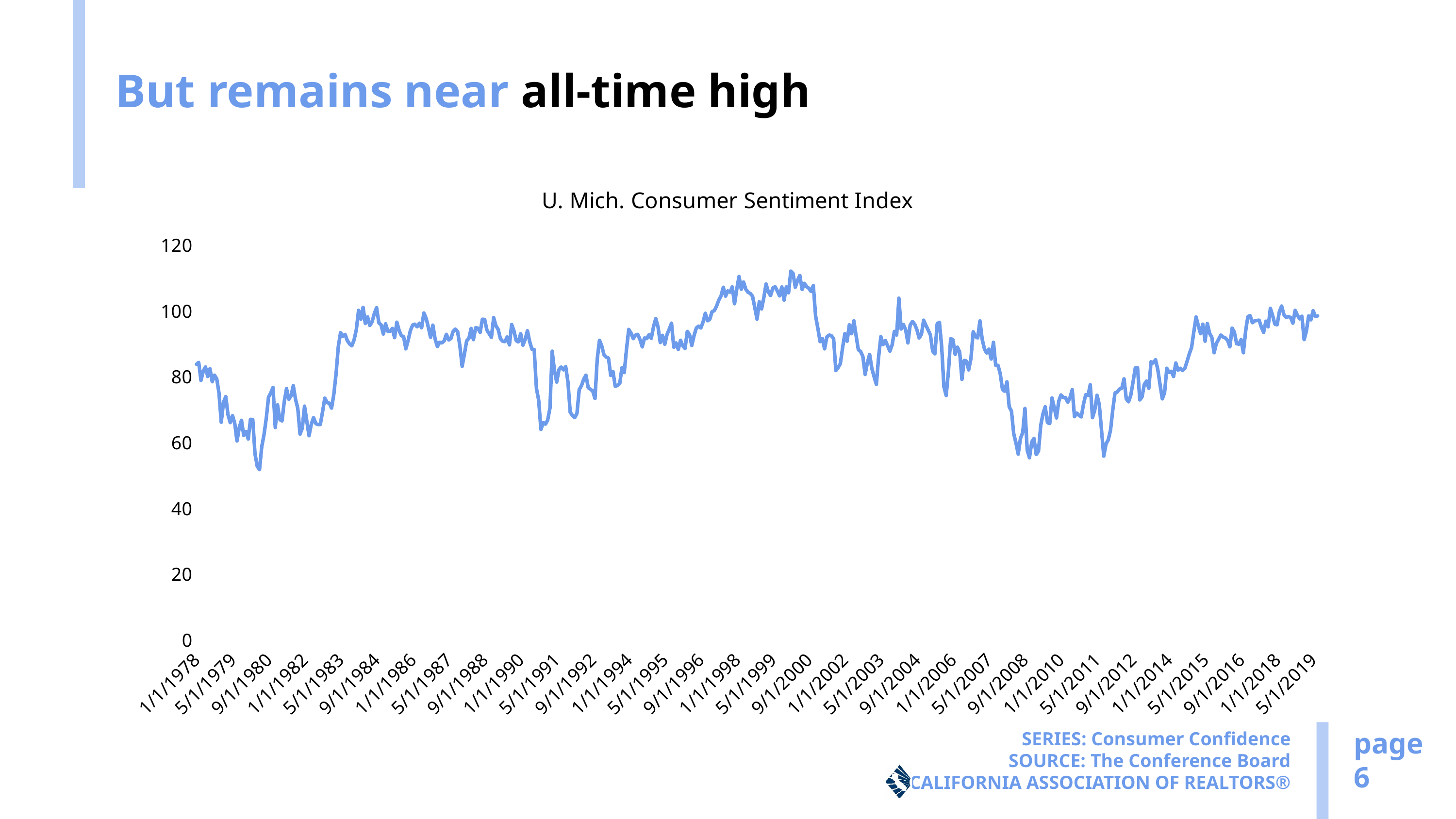
Does the index rise or fall overall between 1/1/2000 and 9/1/2008? fall What kind of chart is shown on the slide? line chart What is the highest value shown on the y axis? 120 How many lines (series) are plotted on the chart? 1 Is the value around 1/1/1998 greater or less than 100? greater Which is larger, the value around 1/1/2000 or the value around 9/1/2008? 1/1/2000 Is the value around 1/1/2000 greater or less than 100? greater Does the index rise or fall overall between 9/1/2008 and 5/1/2019? rise What is the title of the chart? U. Mich. Consumer Sentiment Index How many date labels are shown on the x axis? 32 Is the value around 9/1/2008 greater or less than 80? less